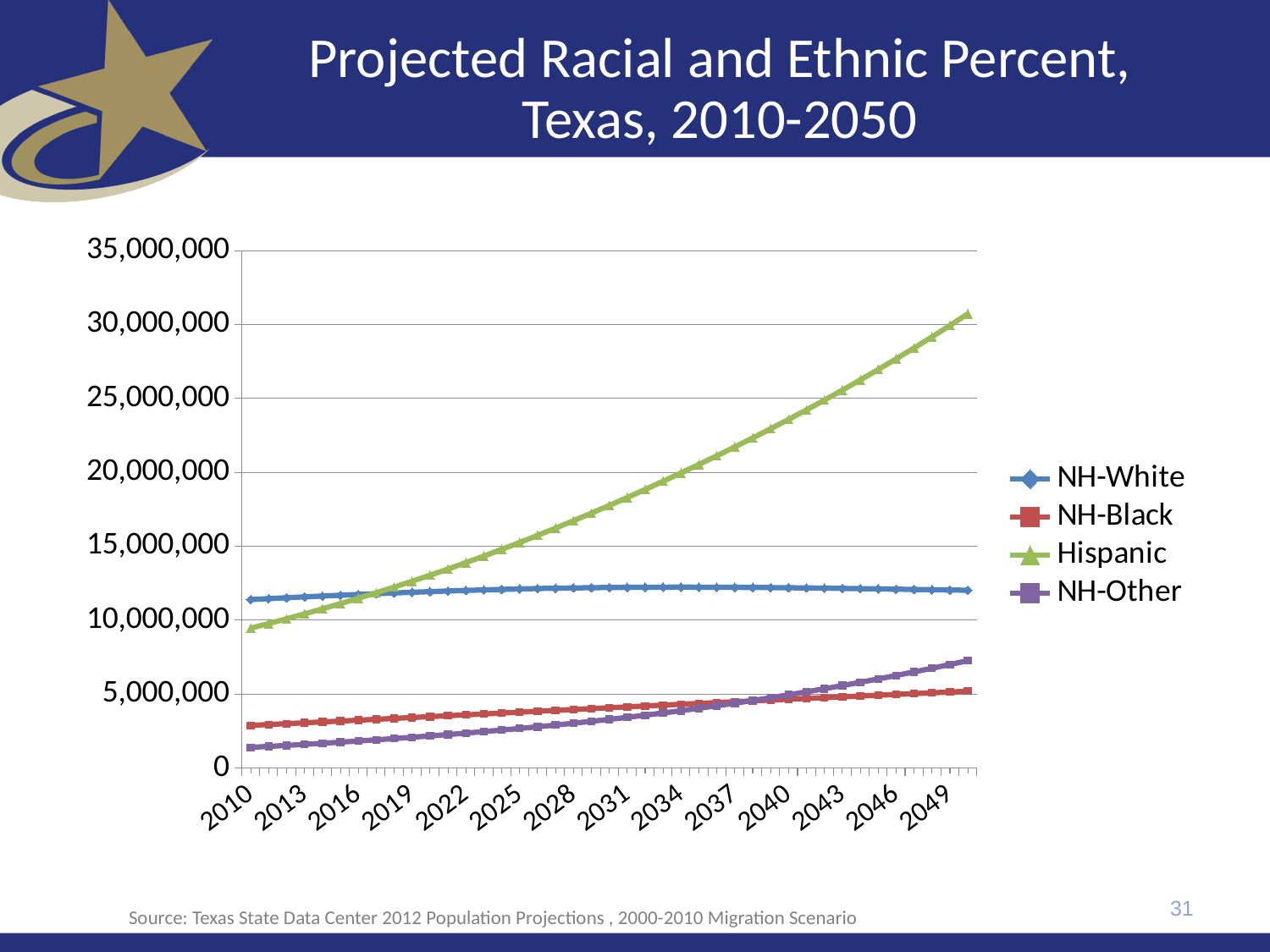
Does the Hispanic series rise or fall from 2010 to 2049? rise How many series does the legend list? 4 Which series has the lowest value in 2010? NH-Other What kind of chart is shown on the slide? line chart Is the Hispanic value in 2049 greater or less than 25,000,000? greater Which series has the highest value in 2049? Hispanic In 2010, which is larger: NH-White or Hispanic? NH-White Which series is drawn in green? Hispanic What is the title of the chart? Projected Racial and Ethnic Percent, Texas, 2010-2050 Is the Hispanic value in 2010 greater or less than 10,000,000? less Is the NH-Black value in 2010 greater or less than 5,000,000? less In 2049, which is larger: NH-Black or NH-Other? NH-Other